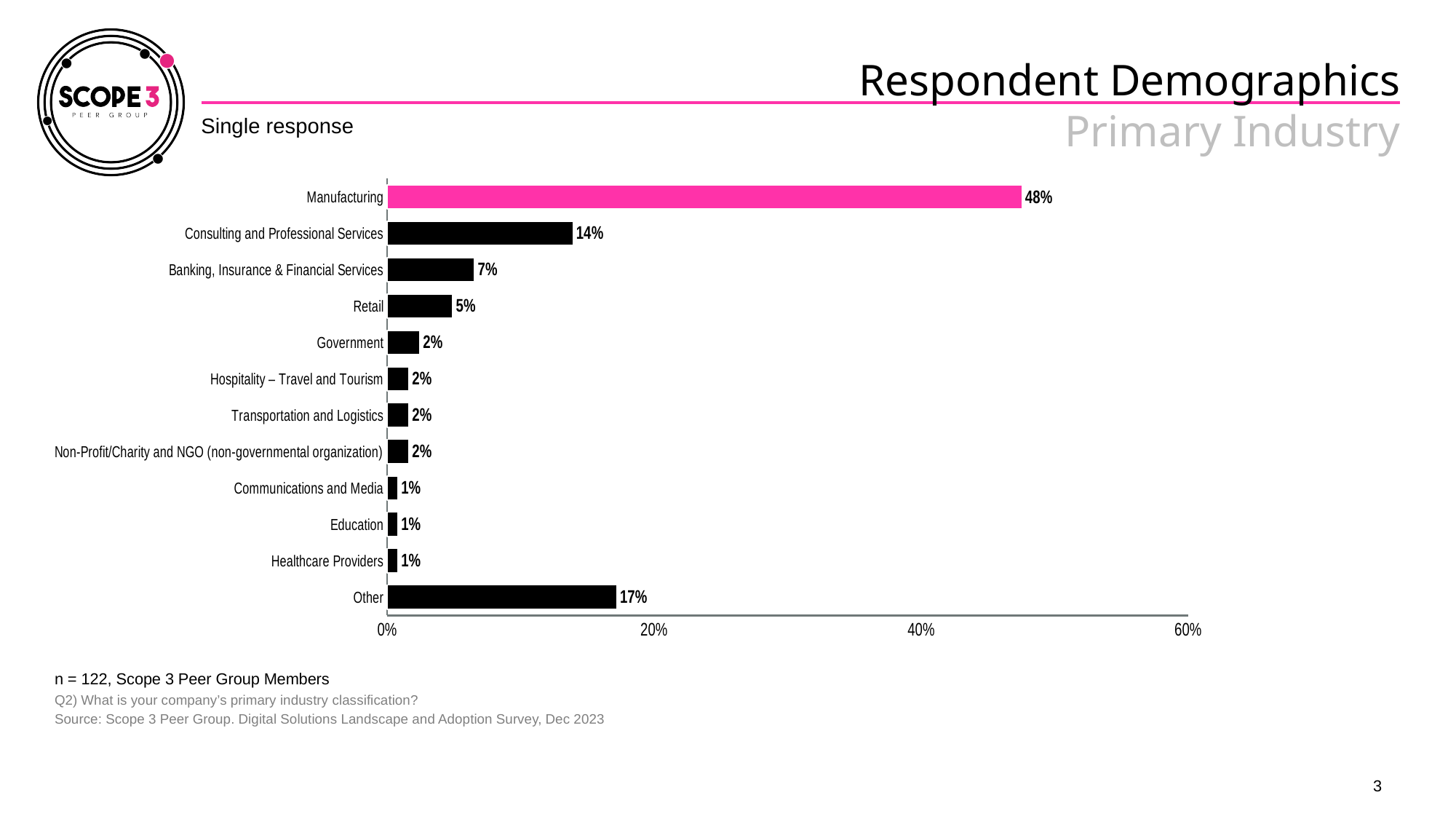
What is the difference between the Manufacturing value and the Consulting and Professional Services value? 34% Is the value for Manufacturing greater or less than 40%? greater Which is larger, the value for Retail or the value for Government? Retail Which industry has the highest share of respondents? Manufacturing How many industry categories are shown on the chart? 12 What kind of chart is shown on the slide? Bar chart What is the value for Banking, Insurance & Financial Services? 7% Which bar is highlighted in pink? Manufacturing What percentage of respondents selected Other as their primary industry? 17% What is the value for Consulting and Professional Services? 14% What is the difference between the Other value and the Retail value? 12% What percentage of respondents are in Manufacturing? 48%